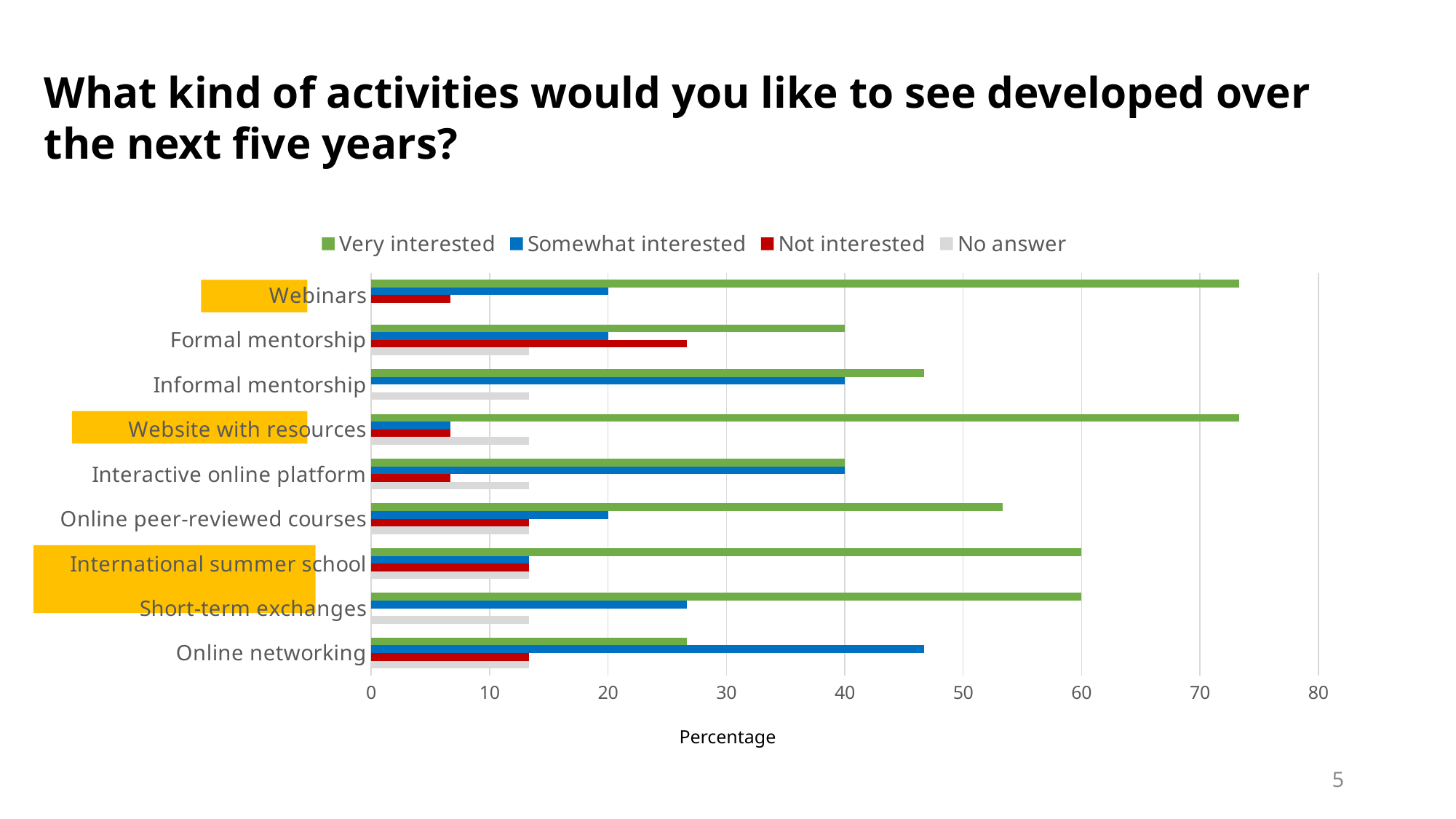
What is the 'Very interested' value for Formal mentorship? 40 Which is larger, the 'Very interested' value for Formal mentorship or for Informal mentorship? Informal mentorship What kind of chart is shown on the slide? bar chart What is the 'Very interested' value for International summer school? 60 How many series does the legend list? 4 Which activity has the lowest 'Very interested' value? Online networking How many activity categories are plotted on the chart? 9 Is the 'Very interested' value for Webinars greater or less than 70? greater Which activity has the highest 'Somewhat interested' value? Online networking What is the 'Somewhat interested' value for Webinars? 20 Which activity has the highest 'Not interested' value? Formal mentorship What is the difference between the 'Very interested' and 'Somewhat interested' values for Formal mentorship? 20